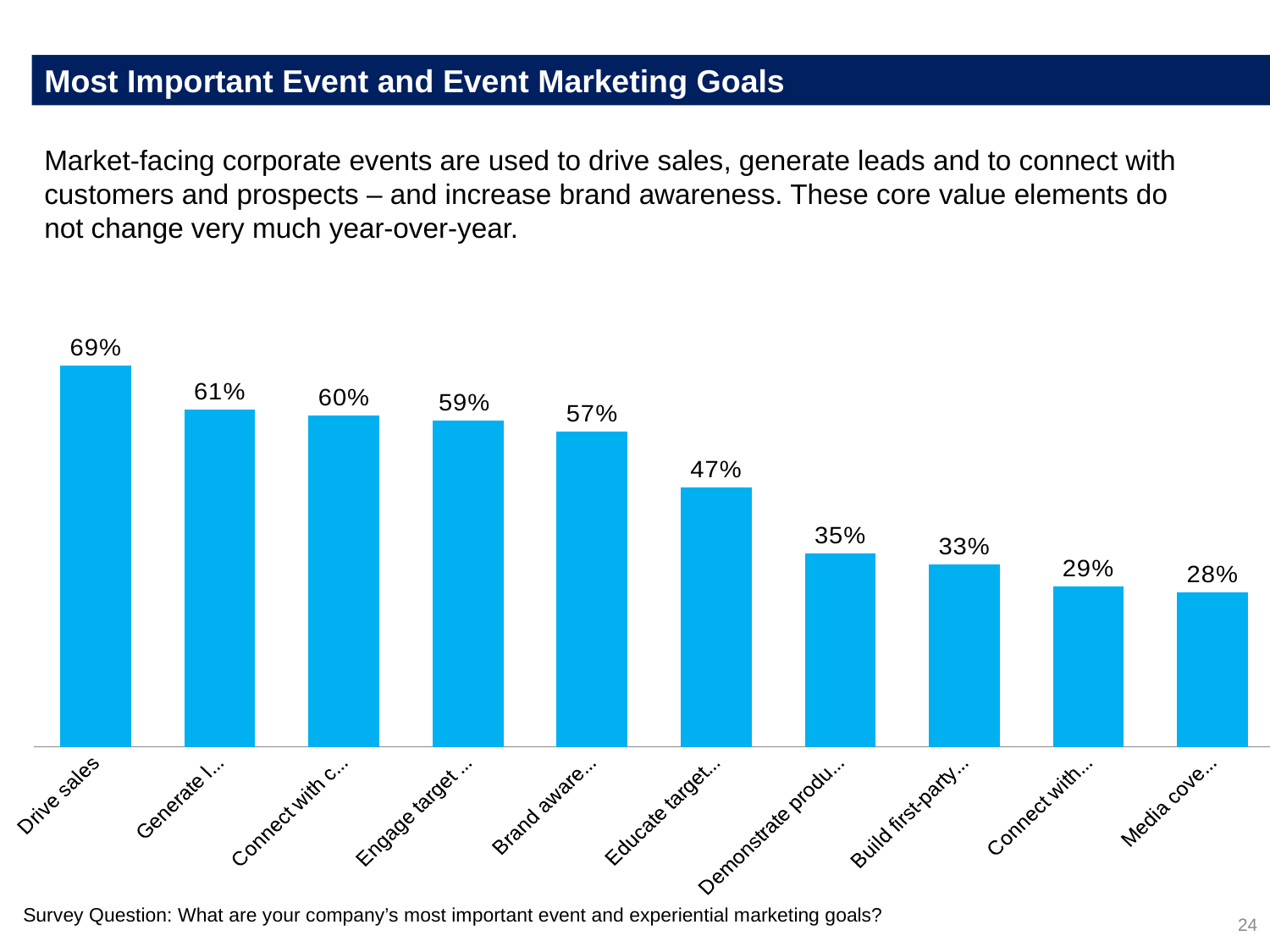
How many bars are shown on the chart? 10 What is the value shown for the last bar on the right (Media cove...)? 28% What is the value for the bar labelled Brand aware...? 57% Which category has the highest value? Drive sales What kind of chart is shown on the slide? Bar chart What is the value for the second bar from the left (Generate l...)? 61% Do the values rise or fall from left to right across the chart? Fall What is the lowest value shown on the chart? 28% Which is larger, the value for the bar labelled Demonstrate produ... or the bar labelled Build first-party...? Demonstrate produ... What is the difference between the value for Drive sales and the value for the bar labelled Educate target...? 22% What is the value for Drive sales? 69% What is the value for the bar labelled Educate target...? 47%